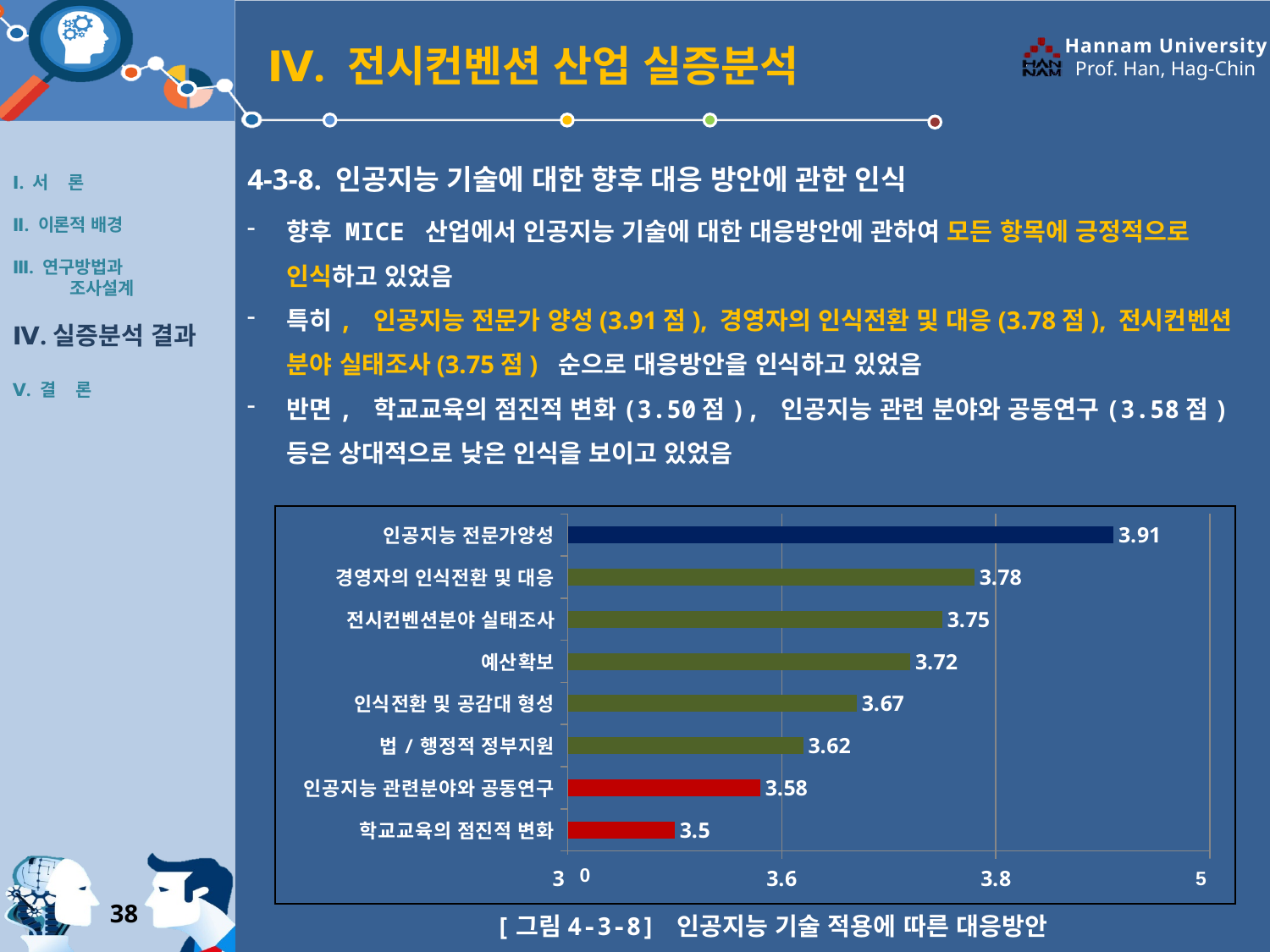
What is the difference between the values for 인공지능 전문가양성 and 학교교육의 점진적 변화? 0.41 How many categories are shown in the chart? 8 What is the value for 예산확보? 3.72 What is the caption of the chart? [그림 4-3-8] 인공지능 기술 적용에 따른 대응방안 What is the value for 법 / 행정적 정부지원? 3.62 Is the value for 인공지능 관련분야와 공동연구 greater or less than 3.6? less Which is larger, the value for 경영자의 인식전환 및 대응 or the value for 인식전환 및 공감대 형성? 경영자의 인식전환 및 대응 Which category has the highest value? 인공지능 전문가양성 What is the value for 학교교육의 점진적 변화? 3.5 What is the value for 인공지능 전문가양성? 3.91 Which category has the lowest value? 학교교육의 점진적 변화 What kind of chart is shown on the slide? bar chart